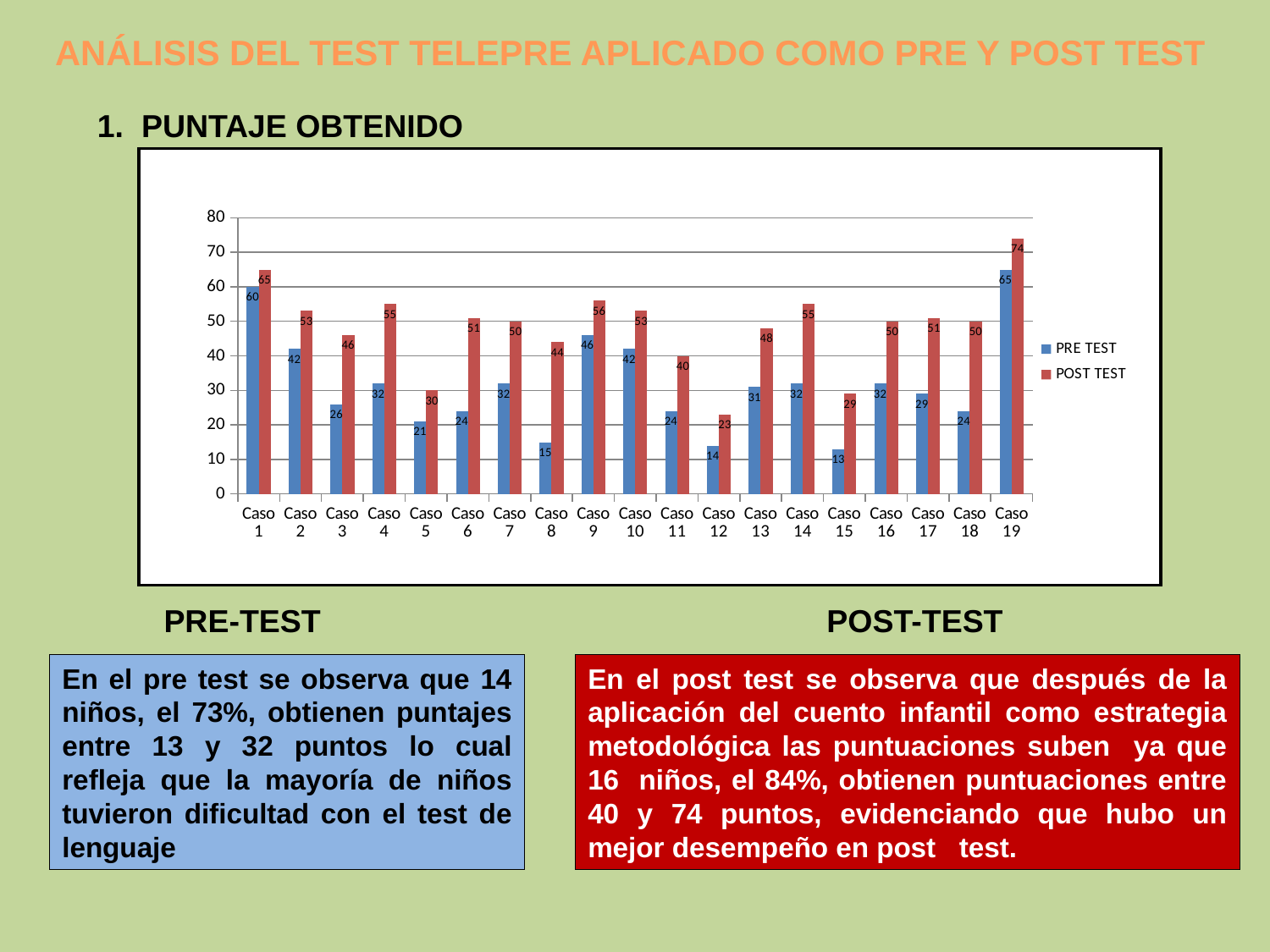
What is the POST TEST value for Caso 19? 74 What colour are the POST TEST bars? Red How many cases are shown on the x axis? 19 Which case has the highest POST TEST value? Caso 19 Which case has the lowest PRE TEST value? Caso 15 Which is larger for Caso 9, the PRE TEST value or the POST TEST value? POST TEST What kind of chart is shown on the slide? Bar chart What is the PRE TEST value for Caso 12? 14 What is the difference between the POST TEST and PRE TEST values for Caso 3? 20 What is the POST TEST value for Caso 5? 30 How many series does the legend list? 2 What is the PRE TEST value for Caso 1? 60